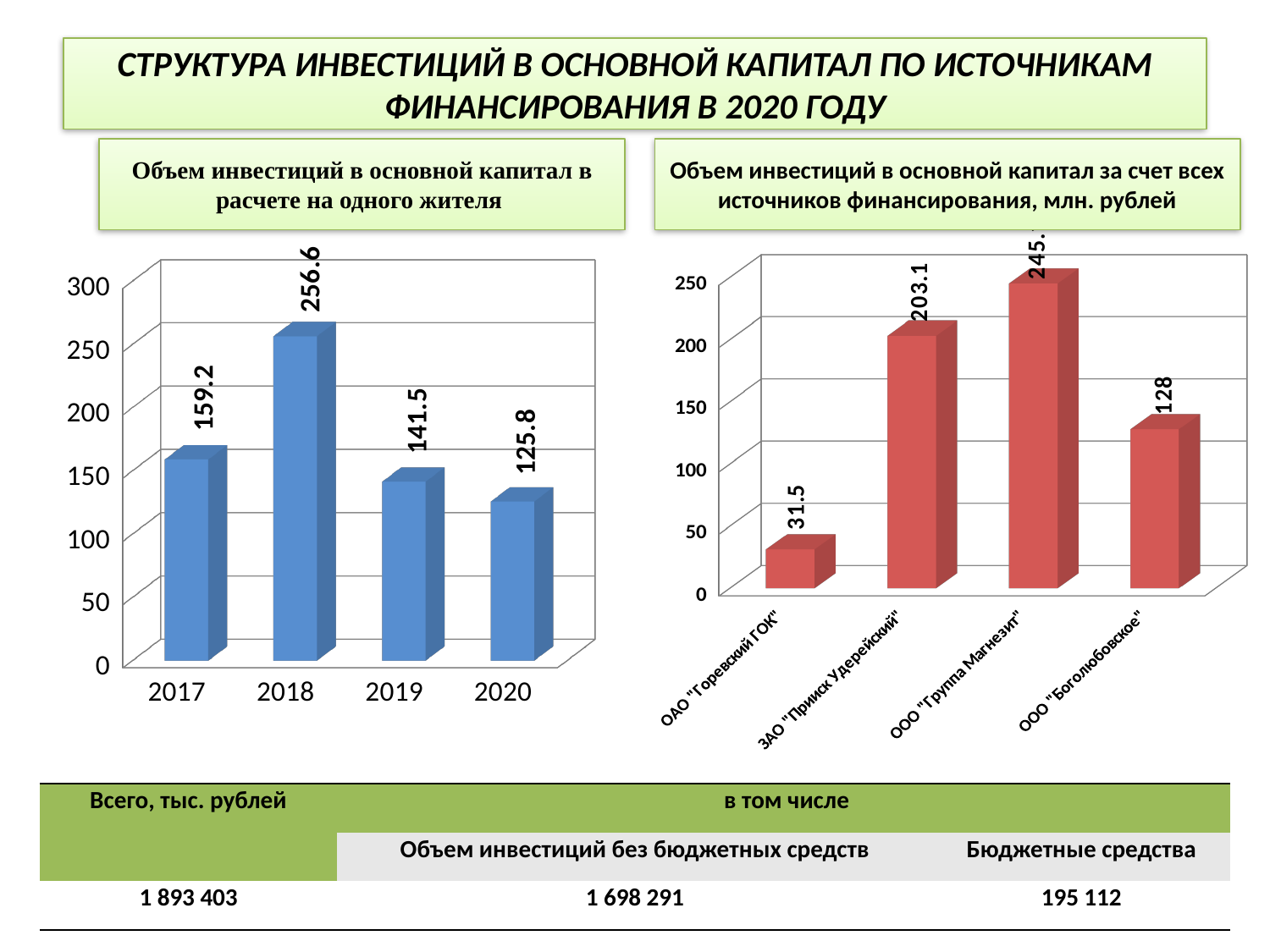
In the left chart (Объем инвестиций в основной капитал в расчете на одного жителя), what is the value for 2020? 125.8 In the left chart (Объем инвестиций в основной капитал в расчете на одного жителя), what is the difference between the values for 2017 and 2019? 17.7 In the left chart (Объем инвестиций в основной капитал в расчете на одного жителя), which year has the lowest value? 2020 In the right chart (Объем инвестиций в основной капитал за счет всех источников финансирования, млн. рублей), what is the value for ОАО "Горевский ГОК"? 31.5 In the left chart (Объем инвестиций в основной капитал в расчете на одного жителя), how many years are shown? 4 In the left chart (Объем инвестиций в основной капитал в расчете на одного жителя), which year has the highest value? 2018 In the right chart (Объем инвестиций в основной капитал за счет всех источников финансирования, млн. рублей), is the value for ООО "Группа Магнезит" greater or less than 200? greater What kind of chart is the left chart (Объем инвестиций в основной капитал в расчете на одного жителя)? bar chart In the right chart (Объем инвестиций в основной капитал за счет всех источников финансирования, млн. рублей), what is the value for ООО "Боголюбовское"? 128 In the left chart (Объем инвестиций в основной капитал в расчете на одного жителя), what is the value for 2018? 256.6 In the left chart (Объем инвестиций в основной капитал в расчете на одного жителя), do the values rise or fall from 2018 to 2020? fall In the right chart (Объем инвестиций в основной капитал за счет всех источников финансирования, млн. рублей), which company has the lowest value? ОАО "Горевский ГОК"